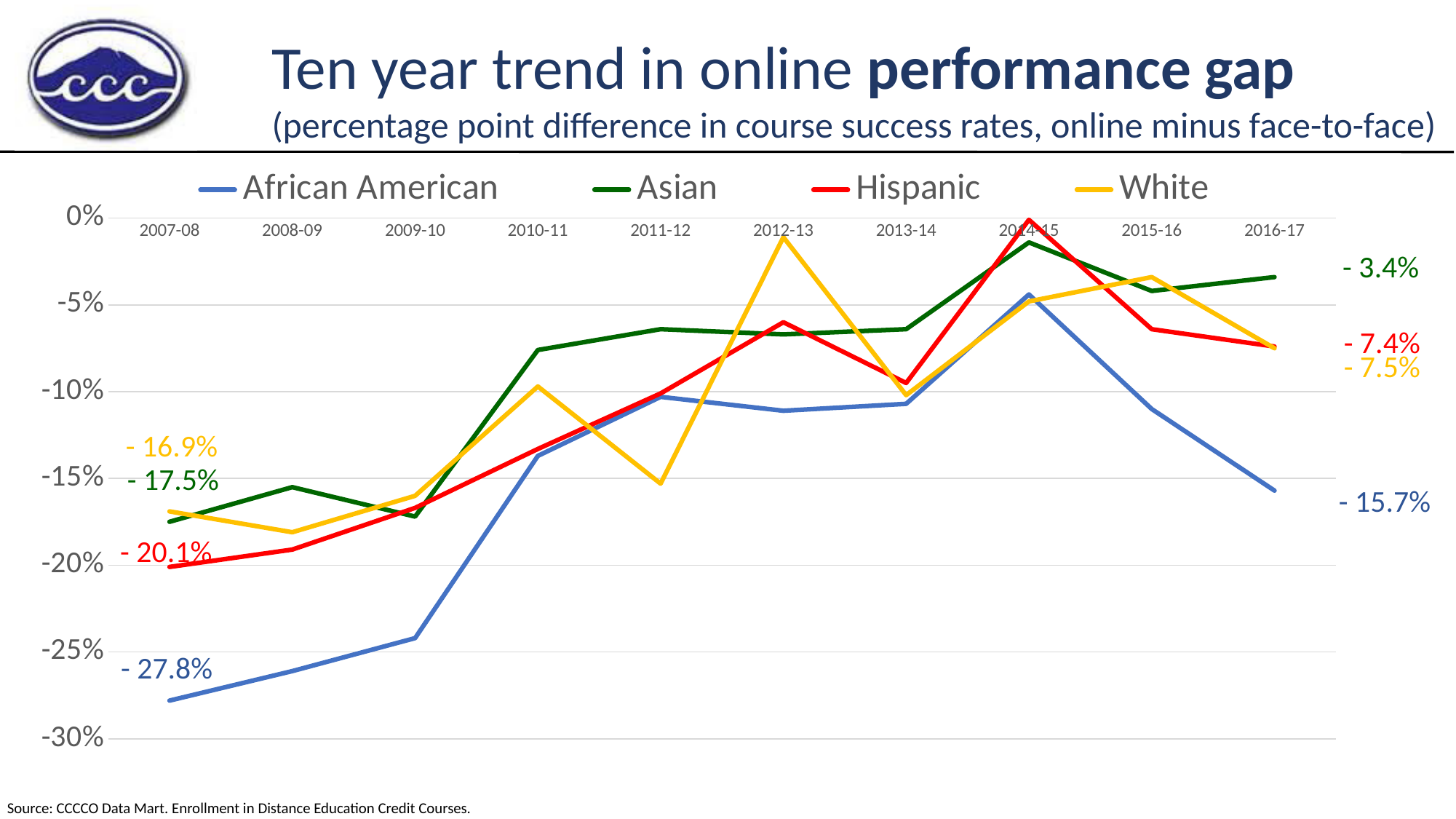
Which series has the lowest value in 2007-08? African American What is the value for African American in 2007-08? - 27.8% What is the value for White in 2016-17? - 7.5% Which series has the highest value in 2016-17? Asian What is the value for Hispanic in 2007-08? - 20.1% How many series does the legend list? 4 Is the value for African American in 2009-10 greater or less than -20%? less How many academic years are plotted along the x axis? 10 By how many percentage points did the African American value change from 2007-08 (- 27.8%) to 2016-17 (- 15.7%)? 12.1 What kind of chart is shown on the slide? line chart What colour is the Hispanic line in the legend? red What is the value for Asian in 2016-17? - 3.4%